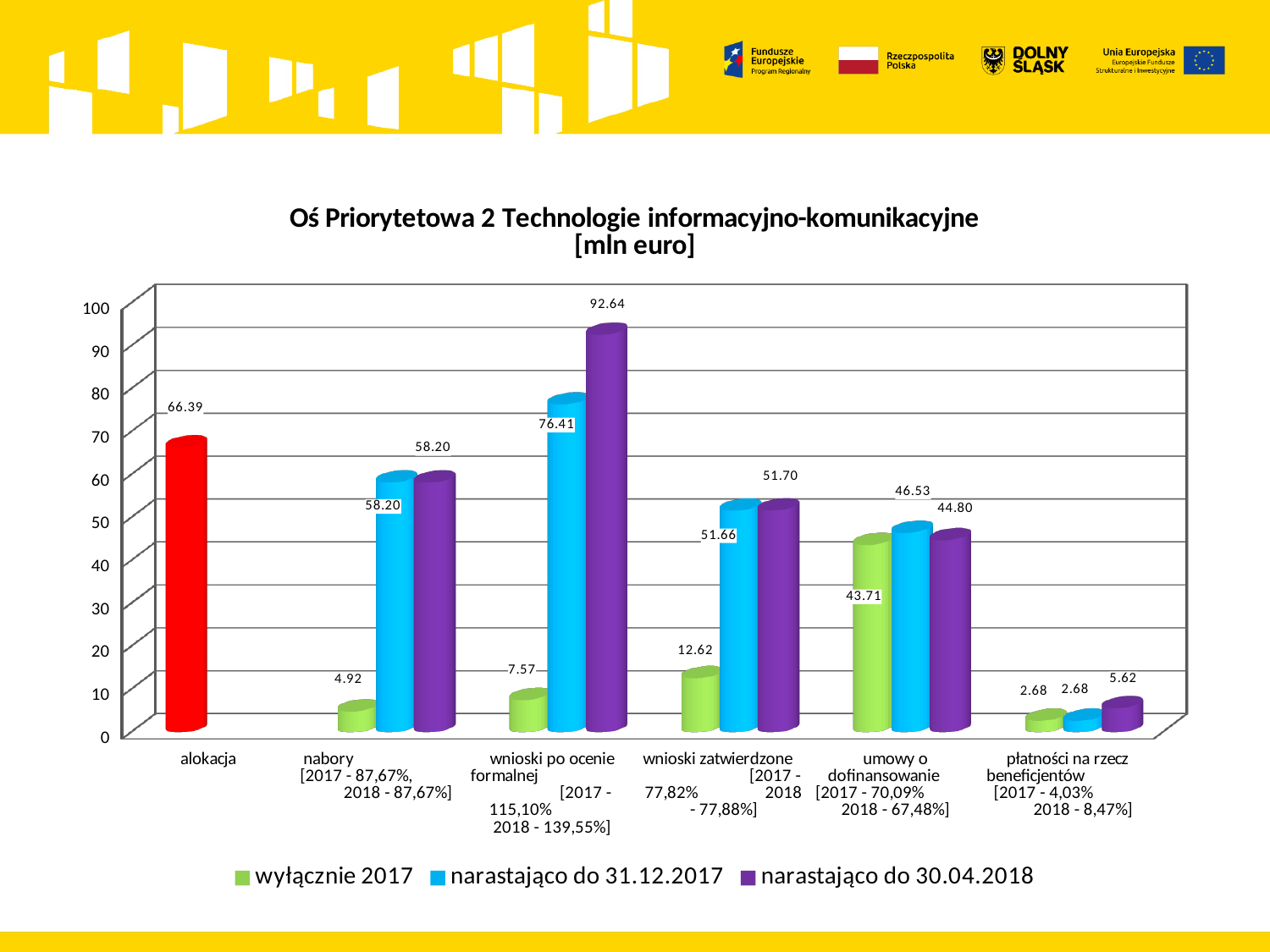
Which category has the lowest value in the 'wyłącznie 2017' series? płatności na rzecz beneficjentów What is the value for 'płatności na rzecz beneficjentów' in the 'narastająco do 30.04.2018' series? 5.62 What is the value of the 'alokacja' bar? 66.39 How many series does the legend list? 3 Which is larger for 'umowy o dofinansowanie': the 'narastająco do 31.12.2017' value or the 'narastająco do 30.04.2018' value? narastająco do 31.12.2017 What kind of chart is shown on the slide? bar chart Which category has the highest value in the 'narastająco do 30.04.2018' series? wnioski po ocenie formalnej What unit is given in the chart title? mln euro Is the 'alokacja' value greater or less than 60? greater What is the difference between the 'narastająco do 30.04.2018' and 'narastająco do 31.12.2017' values for 'wnioski po ocenie formalnej'? 16.23 What is the value for 'wnioski po ocenie formalnej' in the 'narastająco do 30.04.2018' series? 92.64 What is the value for 'umowy o dofinansowanie' in the 'wyłącznie 2017' series? 43.71